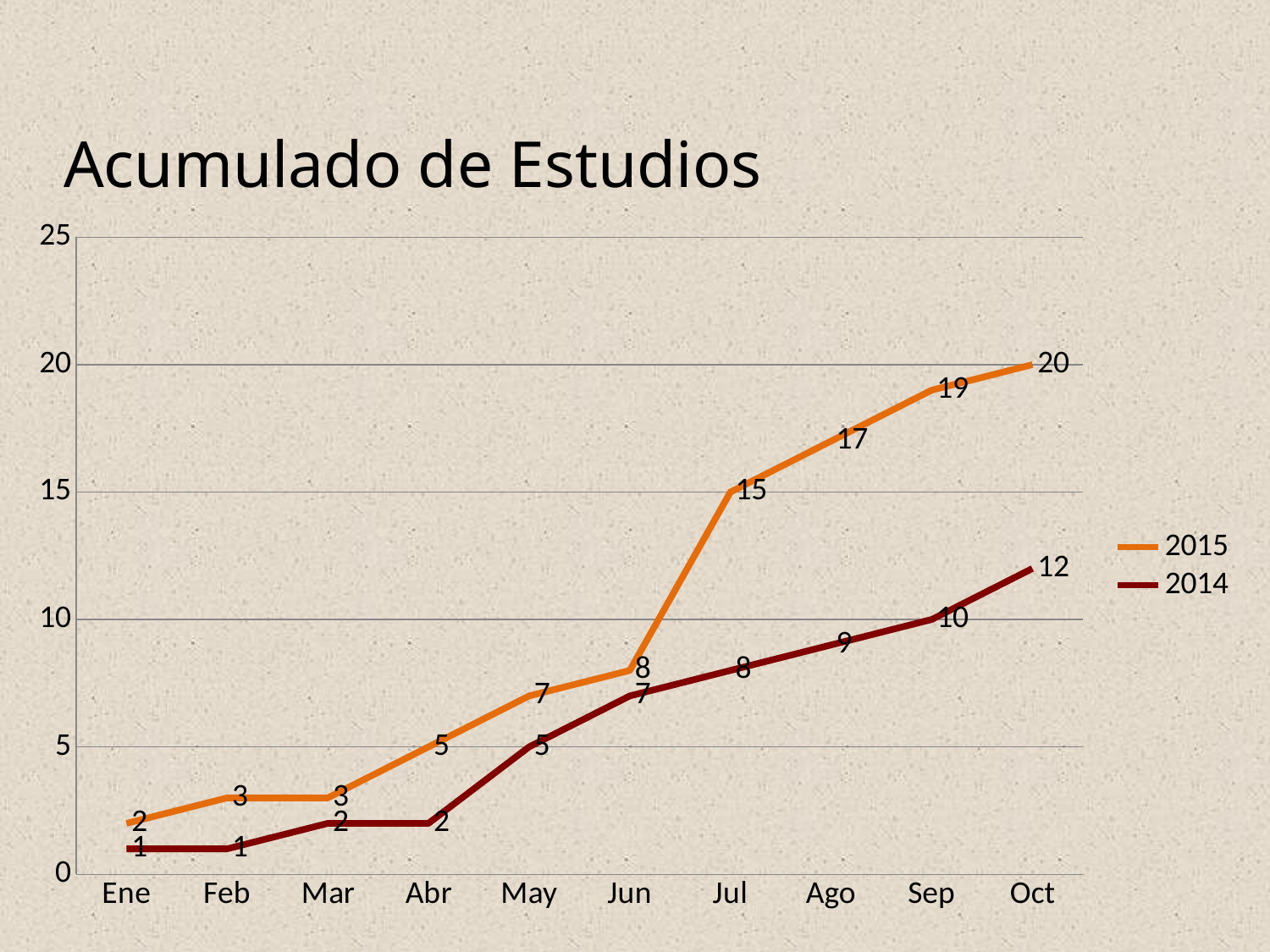
What is the title of the chart? Acumulado de Estudios What is the value for 2014 in Jul? 8 What is the value for 2014 in Ene? 1 Which series has the larger value in Sep, 2015 or 2014? 2015 In which month does the 2015 series reach its highest value? Oct How many months are shown on the x axis? 10 What kind of chart is shown on the slide? Line chart What is the value for 2015 in Oct? 20 What is the difference between the 2015 and 2014 values in Jul? 7 What is the value for 2015 in May? 7 Do the values for 2014 rise or fall from Ene to Oct? Rise How many series does the legend list? 2